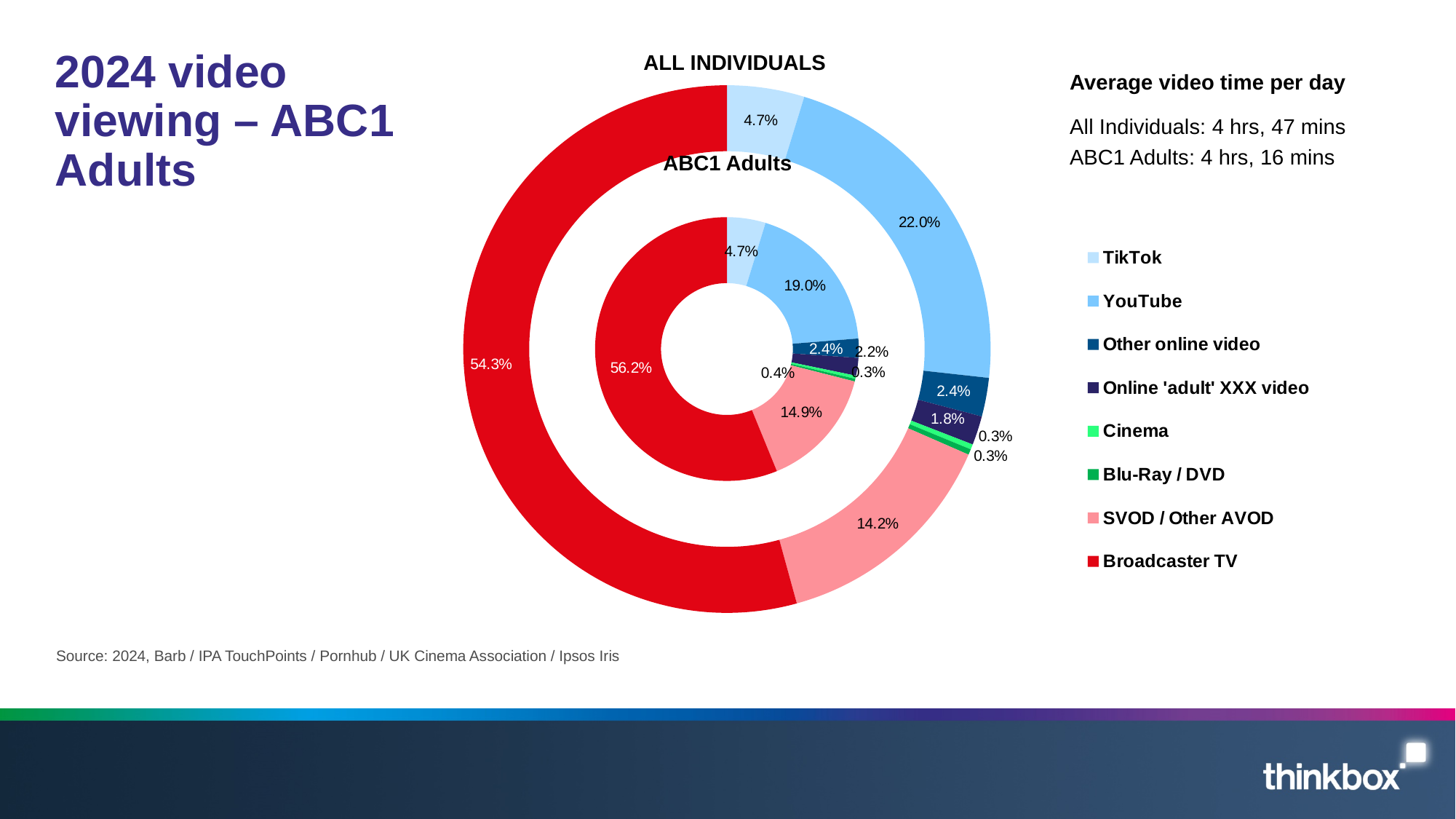
What is the TikTok share in the ABC1 Adults ring? 4.7% By how many percentage points does the YouTube share for ALL INDIVIDUALS exceed the YouTube share for ABC1 Adults? 3.0 percentage points What is the YouTube share in the ALL INDIVIDUALS ring? 22.0% According to the slide, what is the average video time per day for ABC1 Adults? 4 hrs, 16 mins What share of video viewing does Broadcaster TV account for in the ALL INDIVIDUALS ring? 54.3% What share of video viewing does Broadcaster TV account for in the ABC1 Adults ring? 56.2% What is the YouTube share in the ABC1 Adults ring? 19.0% How many categories does the chart legend list? 8 Which category has the largest share in the ABC1 Adults ring? Broadcaster TV What is the SVOD / Other AVOD share in the ALL INDIVIDUALS ring? 14.2% What kind of chart is shown on the slide? Doughnut chart Is the SVOD / Other AVOD share larger for ALL INDIVIDUALS or for ABC1 Adults? ABC1 Adults